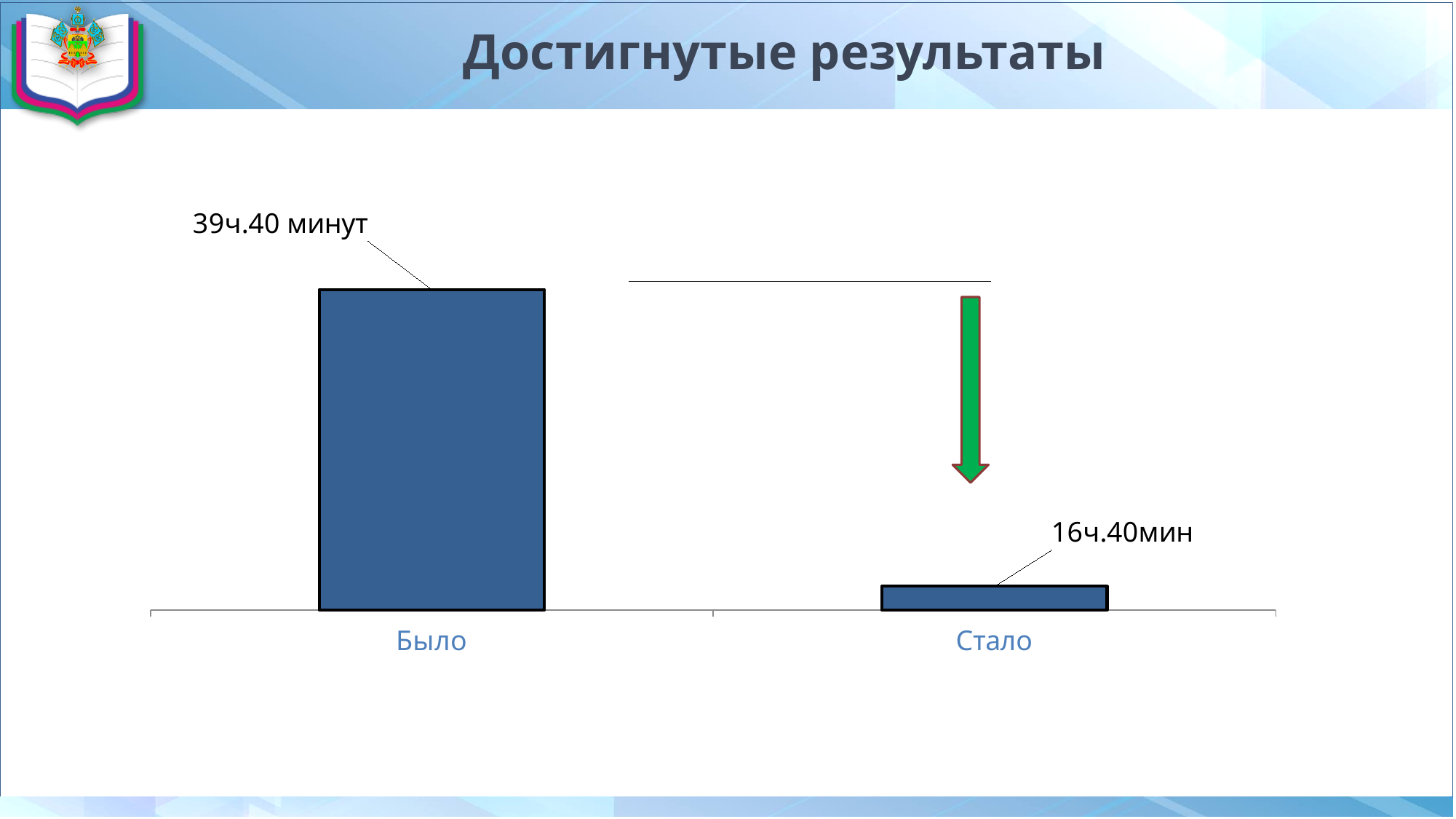
Which is larger, the value for "Было" or the value for "Стало"? Было Do the values rise or fall from "Было" to "Стало"? Fall What value is shown for the "Стало" bar? 16ч.40мин Which category has the lowest value? Стало Which category has the highest value? Было By how many hours does the "Было" value exceed the "Стало" value? 23 часа What value is shown for the "Было" bar? 39ч.40 минут What kind of chart is shown on the slide? Bar chart What is the title of the slide containing the chart? Достигнутые результаты What colour are the bars in the chart? Blue How many categories are shown on the x axis? 2